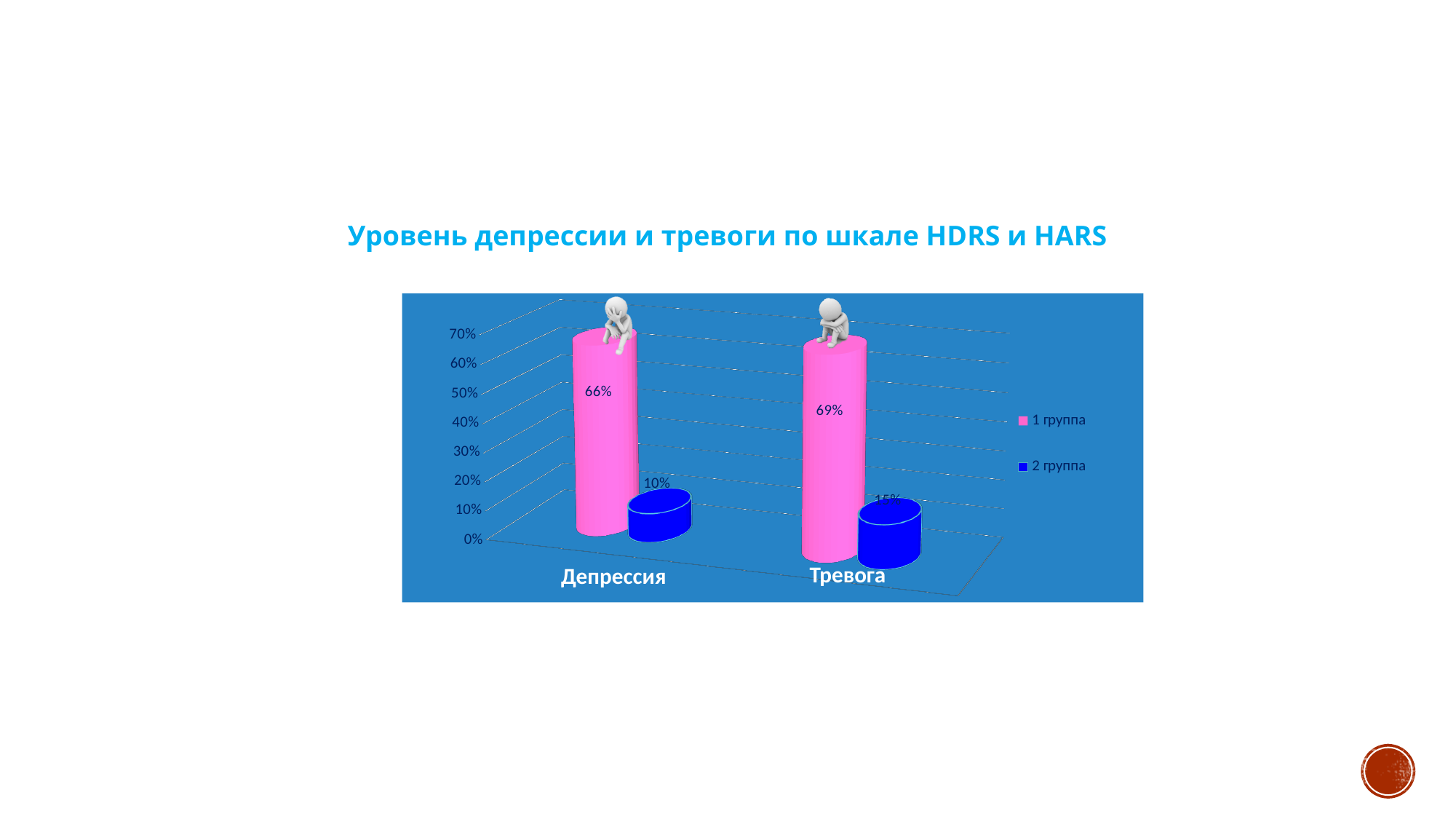
What is the difference between the 1 группа and 2 группа values in the Депрессия category? 56% What kind of chart is shown on the slide? bar chart Which category has the lowest value for 2 группа? Депрессия What is the value for 1 группа in the Тревога category? 69% What is the value for 1 группа in the Депрессия category? 66% Is the value for 1 группа in the Депрессия category greater or less than 50%? greater How many categories are shown on the x axis? 2 What is the value for 2 группа in the Депрессия category? 10% Which category has the highest value for 1 группа? Тревога How many series does the legend list? 2 What is the value for 2 группа in the Тревога category? 15% Which is larger in the Тревога category: the value for 1 группа or for 2 группа? 1 группа